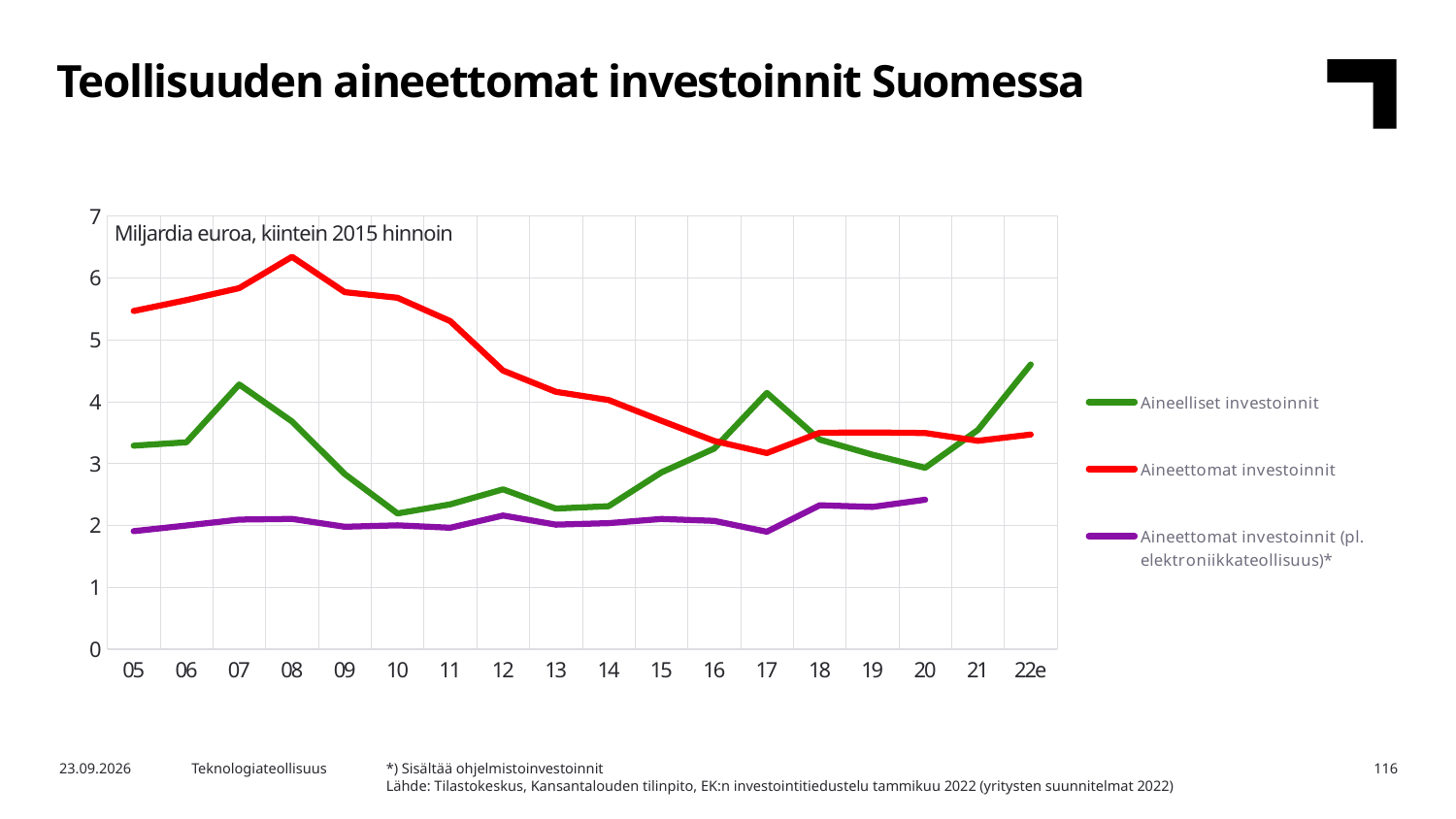
Is the value for Aineelliset investoinnit in 22e greater or less than 4? greater Is the value for Aineettomat investoinnit (pl. elektroniikkateollisuus)* in 17 greater or less than 2? less What unit is stated in the text inside the chart area? Miljardia euroa, kiintein 2015 hinnoin Does the Aineettomat investoinnit series rise or fall between 08 and 17? fall In 17, which series has the larger value: Aineelliset investoinnit or Aineettomat investoinnit? Aineelliset investoinnit In which year does the Aineelliset investoinnit series reach its highest value? 22e What kind of chart is shown on the slide? line chart How many series does the legend list? 3 Is the value for Aineettomat investoinnit in 08 greater or less than 6? greater How many categories are shown on the x axis? 18 In which year does the Aineettomat investoinnit series reach its highest value? 08